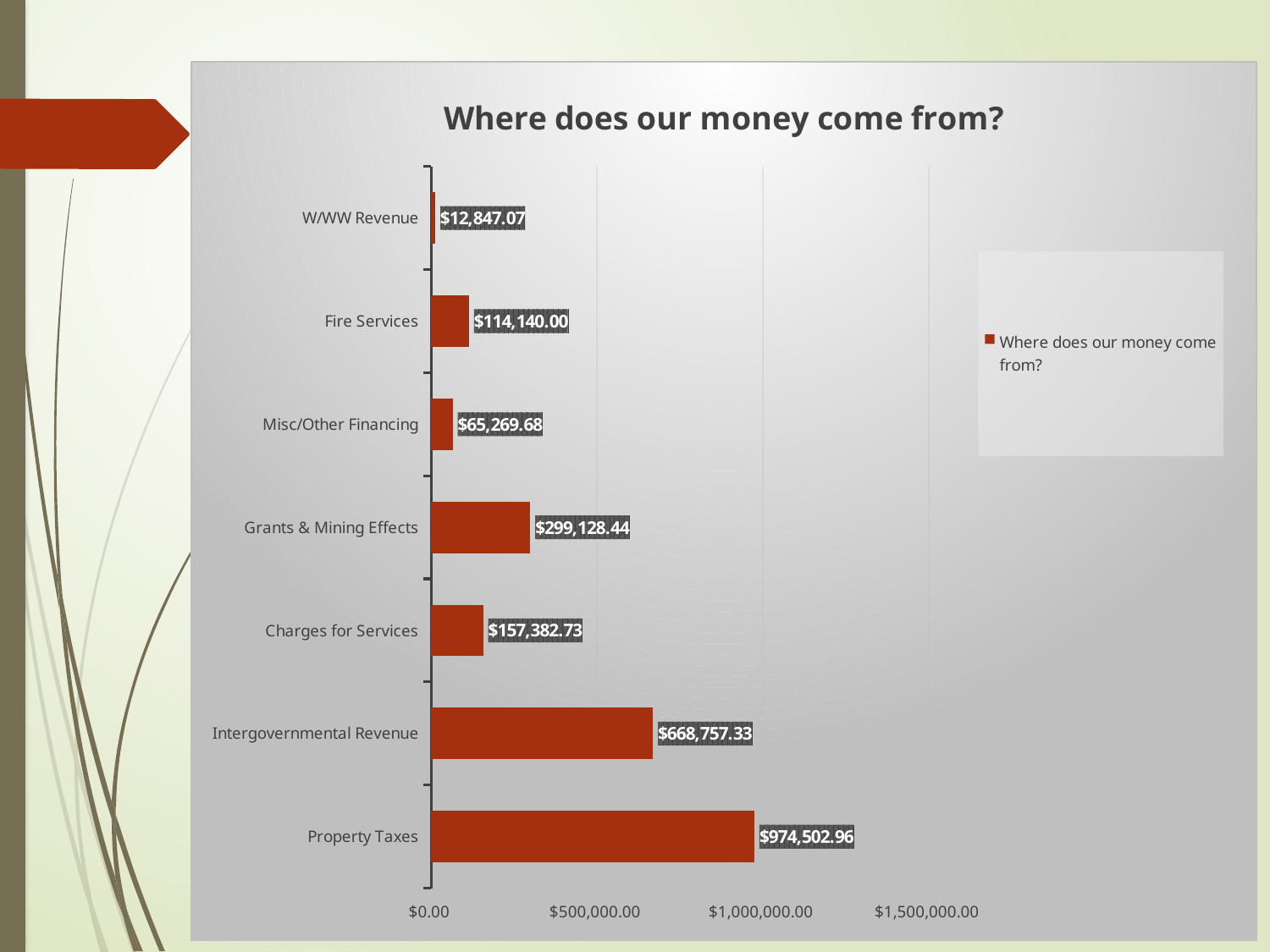
How many categories are shown in the chart? 7 What is the value for Property Taxes? $974,502.96 Which category has the lowest value? W/WW Revenue What is the difference between Charges for Services and Fire Services? $43,242.73 What kind of chart is shown on the slide? Bar chart Is the value for Intergovernmental Revenue greater or less than $500,000.00? greater Which category has the highest value? Property Taxes What is the difference between Property Taxes and Intergovernmental Revenue? $305,745.63 How many series does the legend list? 1 What is the value for Misc/Other Financing? $65,269.68 Which is larger, Grants & Mining Effects or Charges for Services? Grants & Mining Effects What is the value for Grants & Mining Effects? $299,128.44